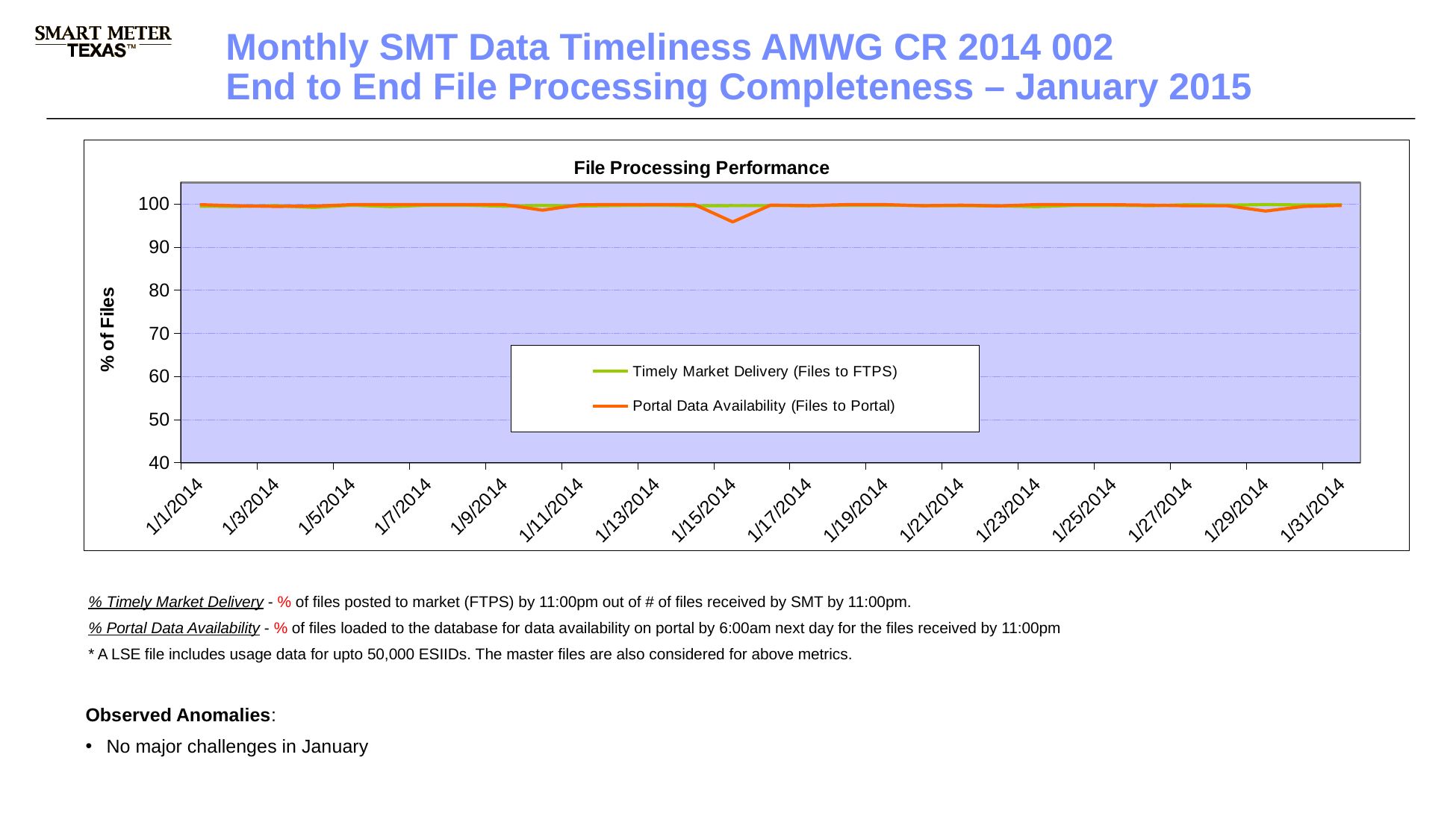
What is the title of the chart? File Processing Performance Is the value for Timely Market Delivery (Files to FTPS) on 1/1/2014 greater or less than 90? greater How many series does the legend of the File Processing Performance chart list? 2 Is the value for Timely Market Delivery (Files to FTPS) on 1/21/2014 greater or less than 70? greater What kind of chart is shown on the slide? line chart Which series shows the lowest dip on the chart, Timely Market Delivery (Files to FTPS) or Portal Data Availability (Files to Portal)? Portal Data Availability (Files to Portal) What is the label on the vertical axis of the chart? % of Files What is the lowest value shown on the vertical axis of the chart? 40 Do the values for Timely Market Delivery (Files to FTPS) stay roughly flat, rise, or fall across January? stay roughly flat Is the value for Portal Data Availability (Files to Portal) on 1/15/2014 greater or less than 90? greater